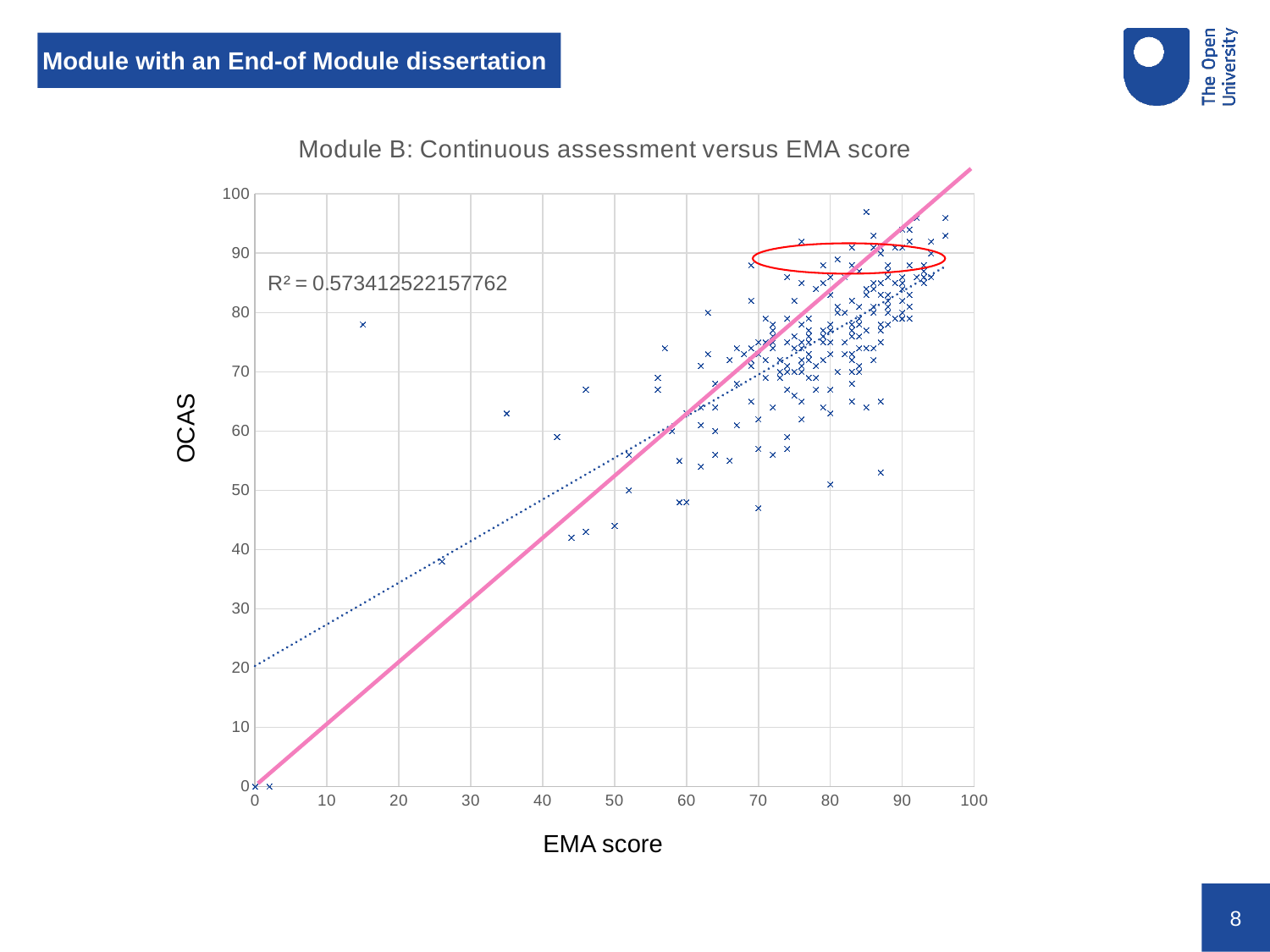
What is the highest tick value shown on the EMA score axis? 100 Is the lowest OCAS value plotted on the chart greater or less than 10? less What R² value is printed on the chart? R² = 0.573412522157762 As the EMA score increases along the x axis, do the OCAS values generally rise or fall? rise Is the OCAS value of the point plotted at an EMA score of about 15 greater or less than 70? greater What is the highest tick value shown on the OCAS axis? 100 What kind of chart is shown on the slide? scatter plot Is the highest OCAS value plotted on the chart greater or less than 90? greater What is the title of the chart? Module B: Continuous assessment versus EMA score What is the label of the horizontal axis of the chart? EMA score